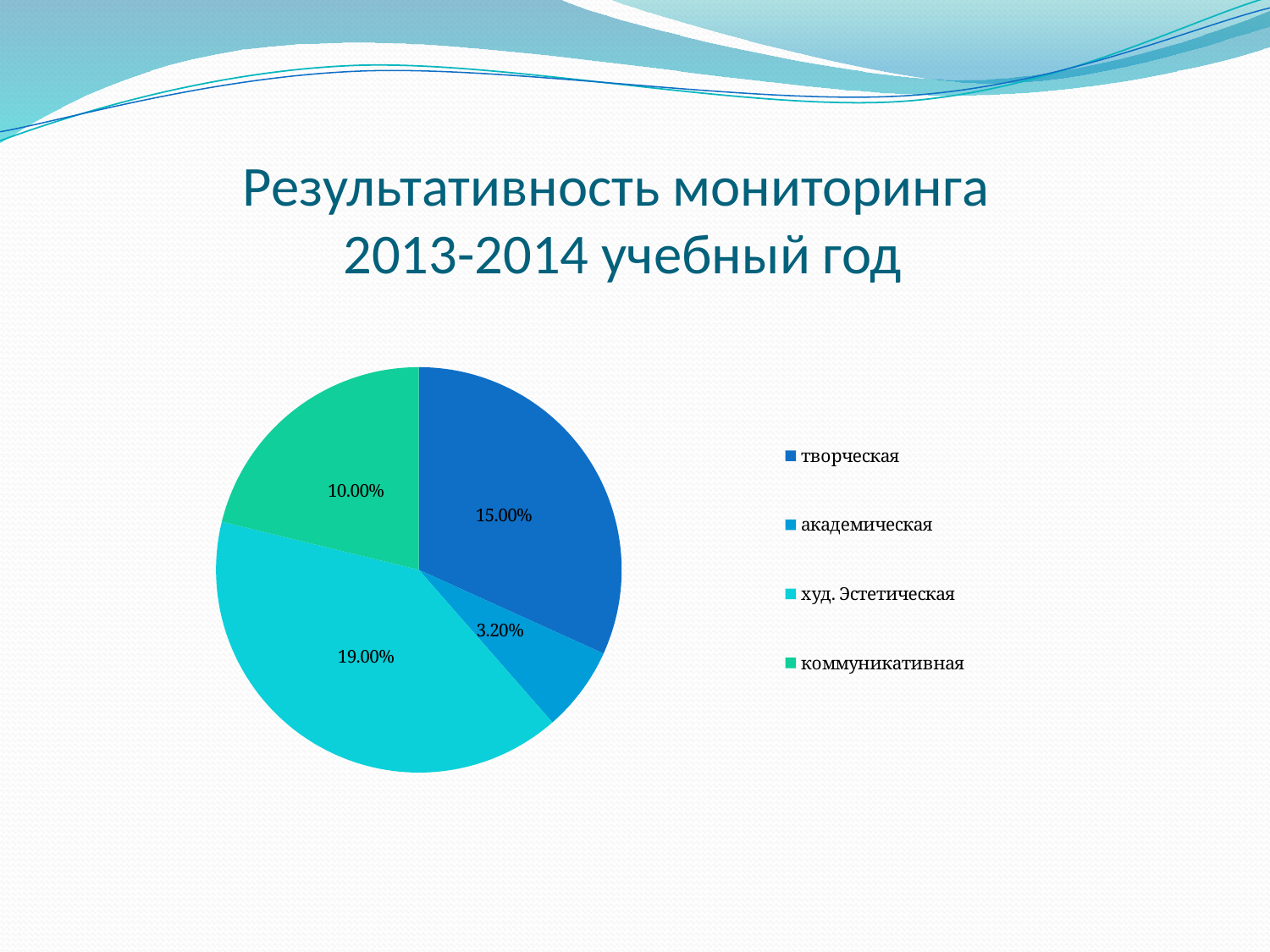
What is the value shown for the академическая slice? 3.20% What is the difference between the values for худ. Эстетическая and творческая? 4.00% What is the value shown for the творческая slice? 15.00% What is the difference between the values for коммуникативная and академическая? 6.80% How many slices does the pie chart have? 4 Which category has the largest slice of the pie? худ. Эстетическая What is the title of the slide containing the chart? Результативность мониторинга 2013-2014 учебный год What is the value shown for the худ. Эстетическая slice? 19.00% What type of chart is shown on the slide? pie chart Which category has the smallest slice of the pie? академическая Which is larger, the value for творческая or the value for коммуникативная? творческая What is the value shown for the коммуникативная slice? 10.00%